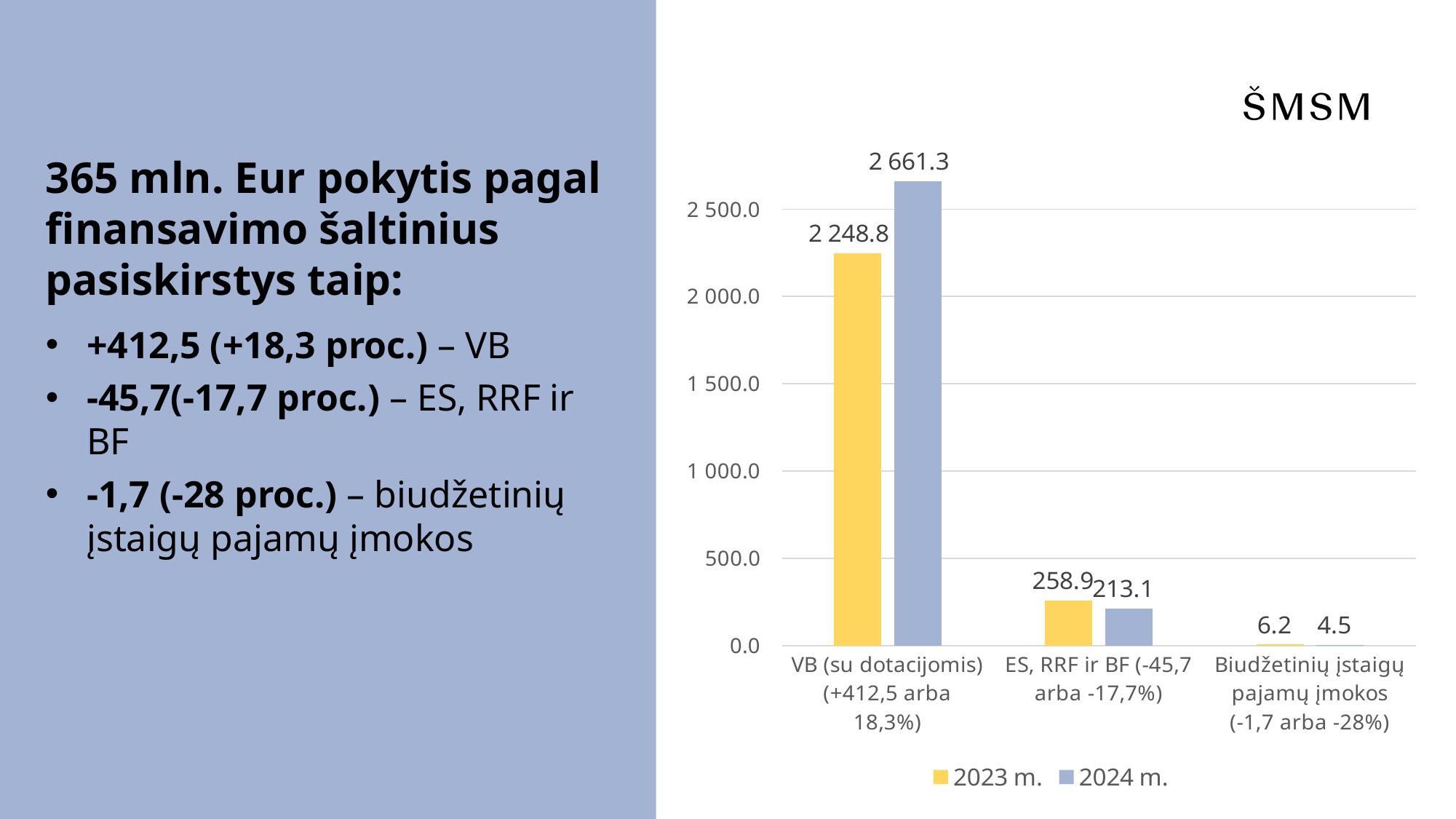
Which category has the highest 2024 m. value? VB (su dotacijomis) What is the difference between the 2024 m. and 2023 m. values for VB (su dotacijomis)? 412.5 What is the 2024 m. value for Biudžetinių įstaigų pajamų įmokos? 4.5 How many categories are shown on the x axis? 3 What is the difference between the 2023 m. and 2024 m. values for Biudžetinių įstaigų pajamų įmokos? 1.7 What kind of chart is shown on the slide? Bar chart What is the 2024 m. value for VB (su dotacijomis)? 2 661.3 What is the 2023 m. value for ES, RRF ir BF? 258.9 What is the 2023 m. value for VB (su dotacijomis)? 2 248.8 For ES, RRF ir BF, which is larger: the 2023 m. value or the 2024 m. value? 2023 m. How many series does the legend list? 2 Which category has the lowest 2023 m. value? Biudžetinių įstaigų pajamų įmokos